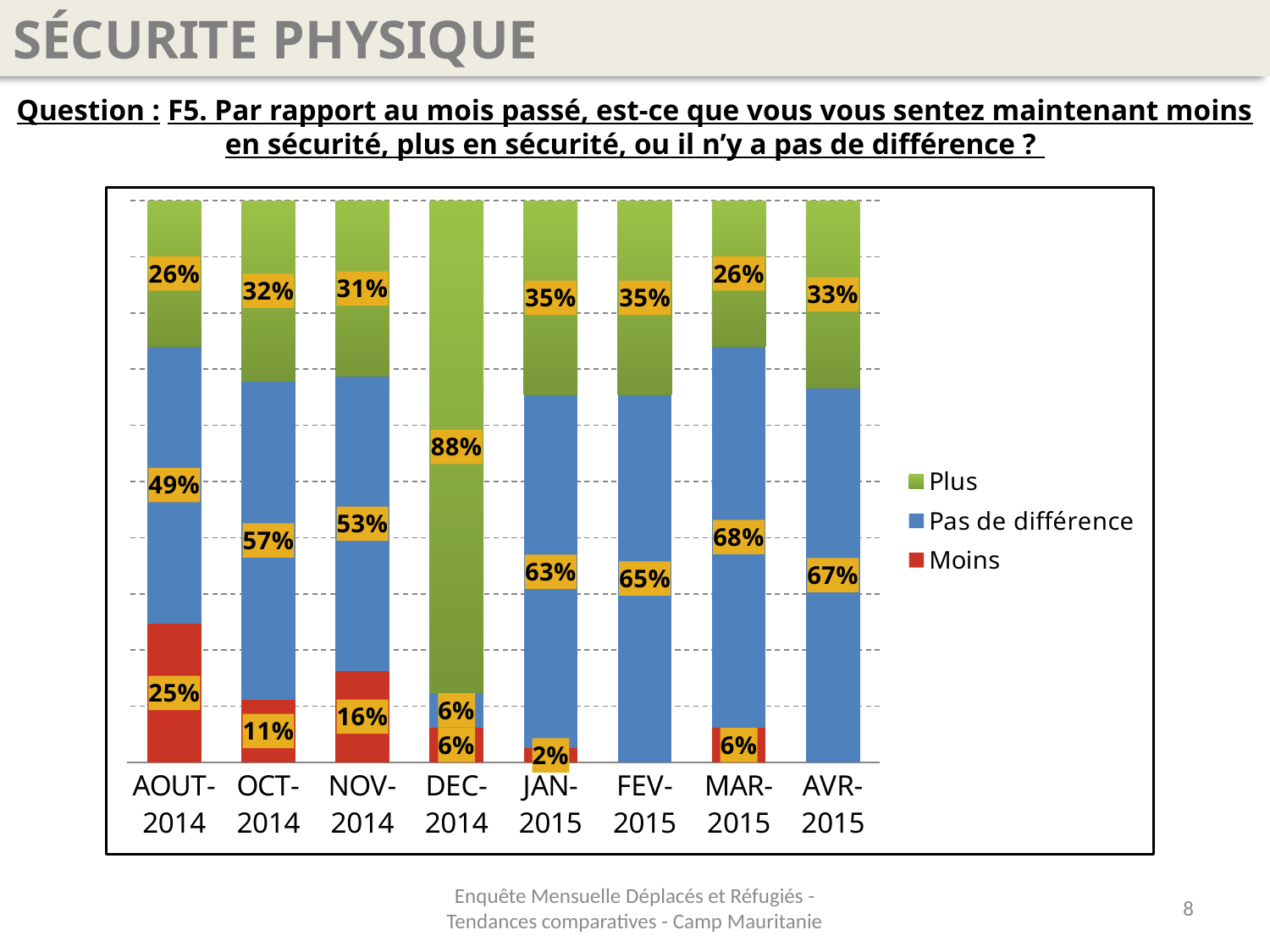
Which series is shown in red in the chart? Moins Which month has the highest value for "Plus"? DEC-2014 How many series does the legend list? 3 What is the difference between the "Pas de différence" values for OCT-2014 and AOUT-2014? 8% What is the value of "Moins" for AOUT-2014? 25% What is the value of "Pas de différence" for MAR-2015? 68% What is the value of "Plus" for DEC-2014? 88% How many months are shown on the x axis of the chart? 8 What kind of chart is shown on the slide? stacked bar chart What is the value of "Pas de différence" for DEC-2014? 6% Which month has the highest value for "Moins"? AOUT-2014 Which is larger, the "Plus" value for OCT-2014 or for MAR-2015? OCT-2014